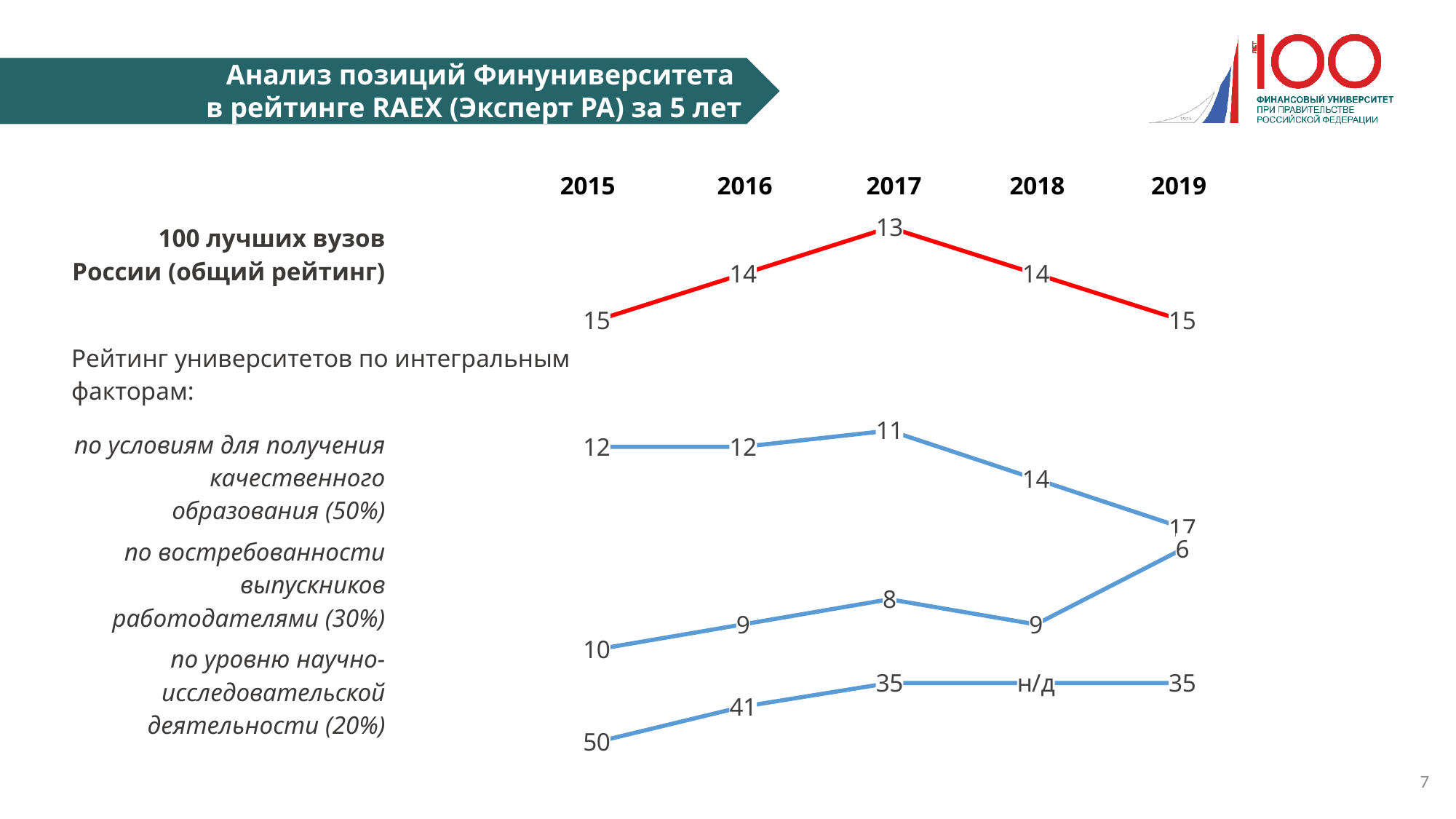
In the red line chart for '100 лучших вузов России (общий рейтинг)', which year has the lowest numeric value? 2017 In the chart for 'по уровню научно-исследовательской деятельности (20%)', what is the value for 2015? 50 In the chart for 'по уровню научно-исследовательской деятельности (20%)', what is shown for 2018? н/д In the chart for 'по условиям для получения качественного образования (50%)', what is the value for 2019? 17 What kind of chart is used to show the rating positions on the slide? Line chart In the chart for 'по уровню научно-исследовательской деятельности (20%)', what is the difference between the 2015 value and the 2016 value? 9 In the chart for 'по условиям для получения качественного образования (50%)', what is the difference between the 2019 value and the 2015 value? 5 How many years are shown along the x axis of the charts? 5 In the red line chart for '100 лучших вузов России (общий рейтинг)', what is the value for 2015? 15 In the chart for 'по востребованности выпускников работодателями (30%)', which year has the lowest numeric value? 2019 In the chart for 'по востребованности выпускников работодателями (30%)', what is the value for 2019? 6 In the red line chart for '100 лучших вузов России (общий рейтинг)', what is the value for 2017? 13